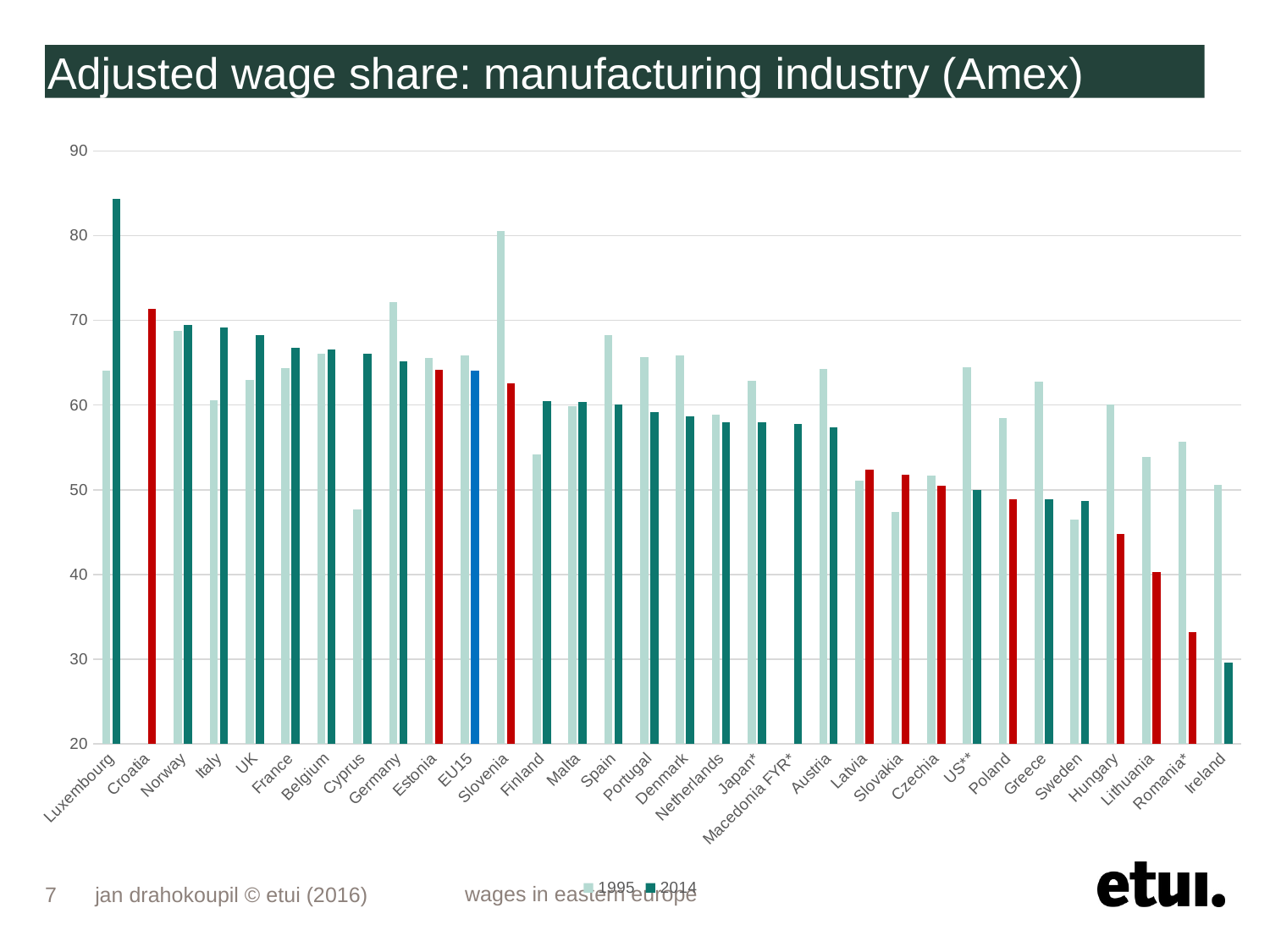
For Slovenia, which is larger: the 1995 value or the 2014 value? 1995 Is the 2014 value for Romania* greater or less than 40? less Which category has the highest 1995 value? Slovenia Do the 2014 values generally rise or fall from left to right along the x axis? fall Is the 2014 value for Luxembourg greater or less than 80? greater Which category has the lowest 2014 value? Ireland How many countries or regions are shown on the x axis? 32 How many series does the legend list? 2 What kind of chart is shown on the slide? bar chart Is the 1995 value for Germany greater or less than 70? greater Which category has the highest 2014 value? Luxembourg Which two years are shown in the legend? 1995 and 2014